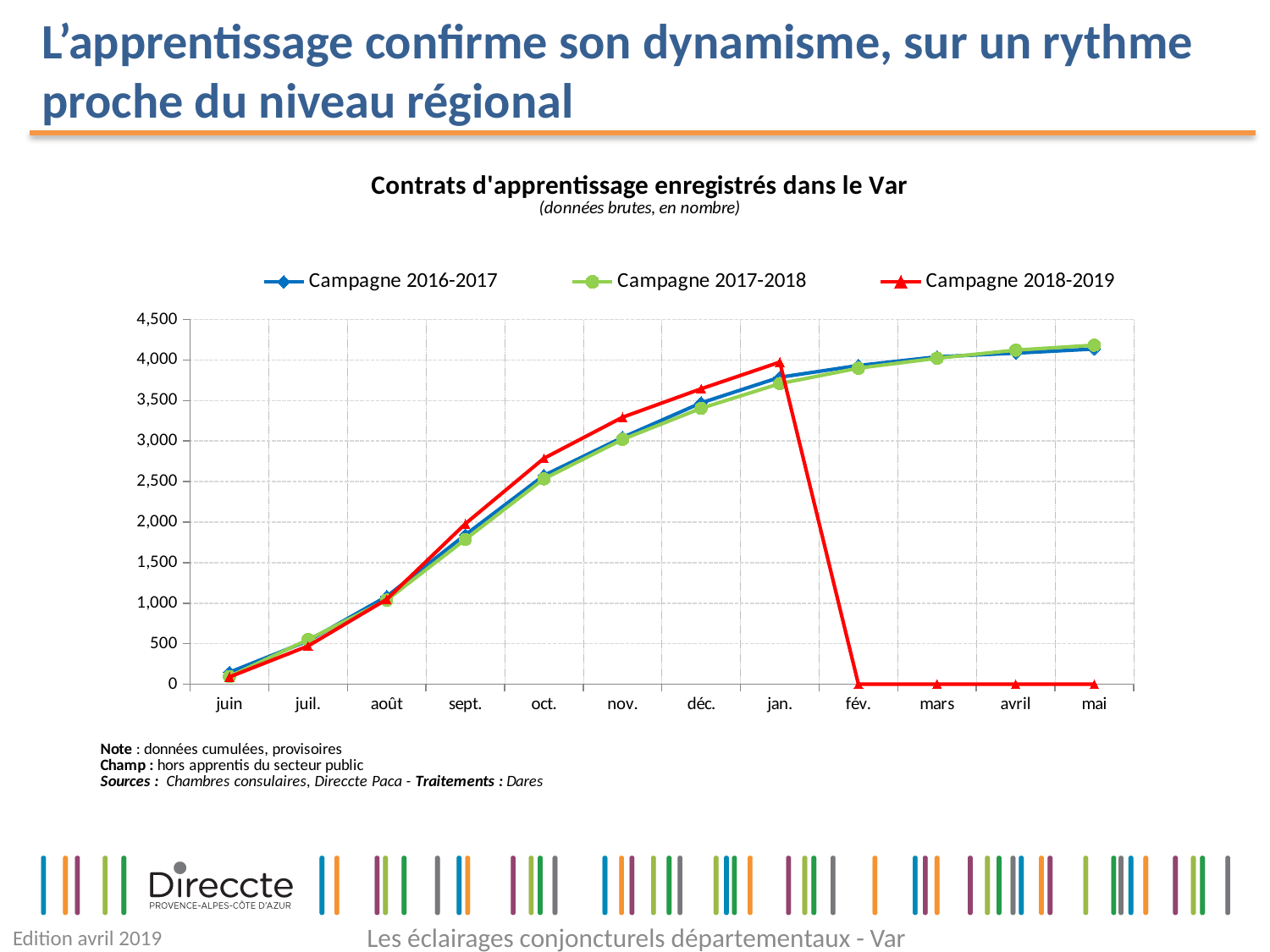
Is the value for Campagne 2016-2017 in oct. greater or less than 3,000? less Is the value for Campagne 2018-2019 in jan. greater or less than 3,500? greater What kind of chart is shown on the slide? line chart In which month does the Campagne 2018-2019 series reach its highest value? jan. Is the value for Campagne 2017-2018 in mai greater or less than 4,000? greater What colour is the line for Campagne 2018-2019? red What is the title of the chart? Contrats d'apprentissage enregistrés dans le Var In nov., which series has the higher value, Campagne 2018-2019 or Campagne 2017-2018? Campagne 2018-2019 How many months are shown on the x axis? 12 How many series does the legend list? 3 Does the Campagne 2017-2018 line rise or fall from juin to mai? rise